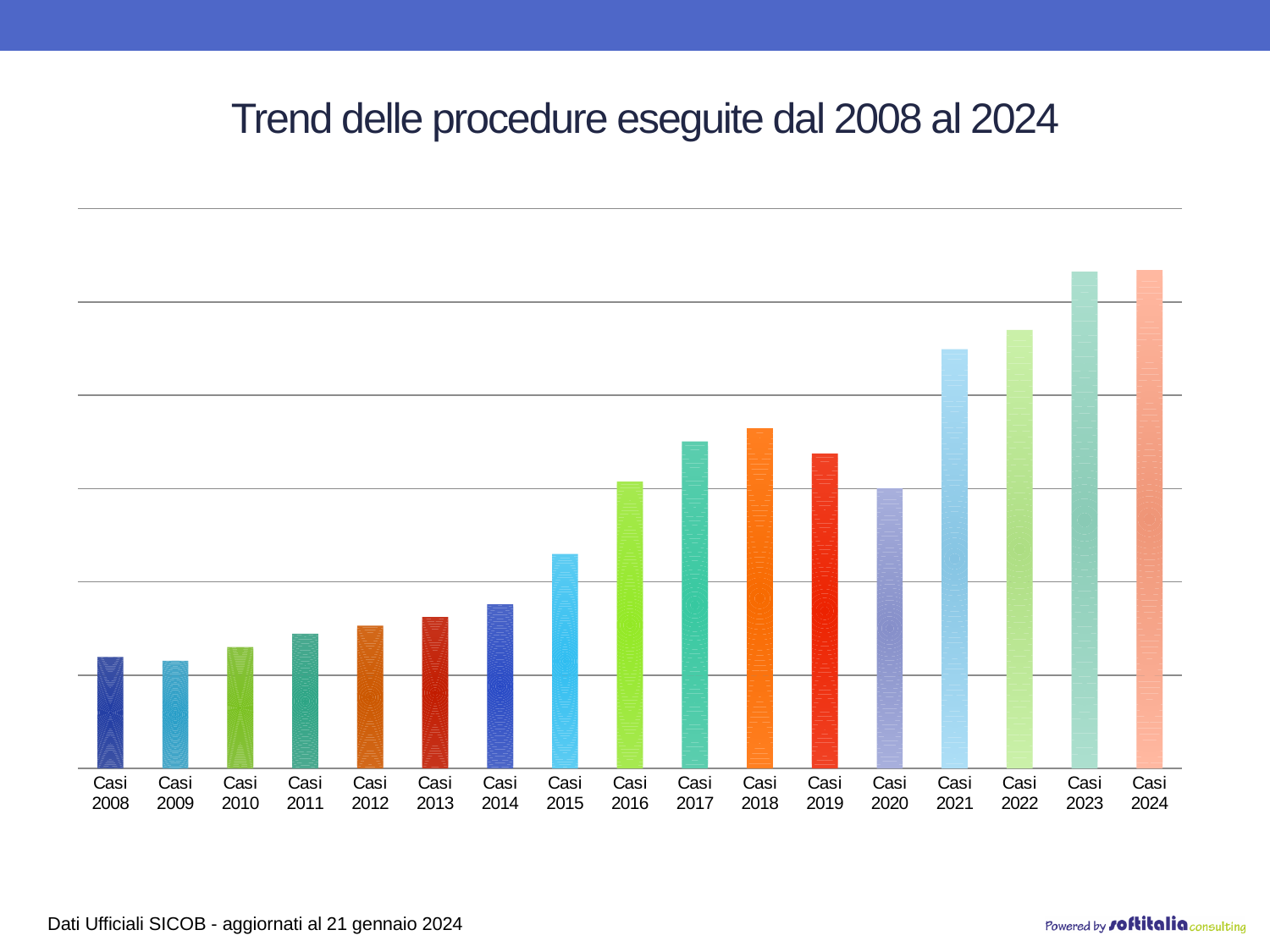
Which is larger, the value for Casi 2018 or Casi 2019? Casi 2018 Which is larger, the value for Casi 2014 or Casi 2017? Casi 2017 Which is larger, the value for Casi 2015 or Casi 2016? Casi 2016 Do the values rise or fall from Casi 2018 to Casi 2020? Fall What data source is cited at the bottom of the slide? Dati Ufficiali SICOB - aggiornati al 21 gennaio 2024 Do the values rise or fall from Casi 2020 to Casi 2023? Rise What kind of chart is shown on the slide? Bar chart How many categories (years) are plotted on the chart? 17 What is the title of the chart? Trend delle procedure eseguite dal 2008 al 2024 Do the values generally rise or fall from Casi 2008 to Casi 2024? Rise